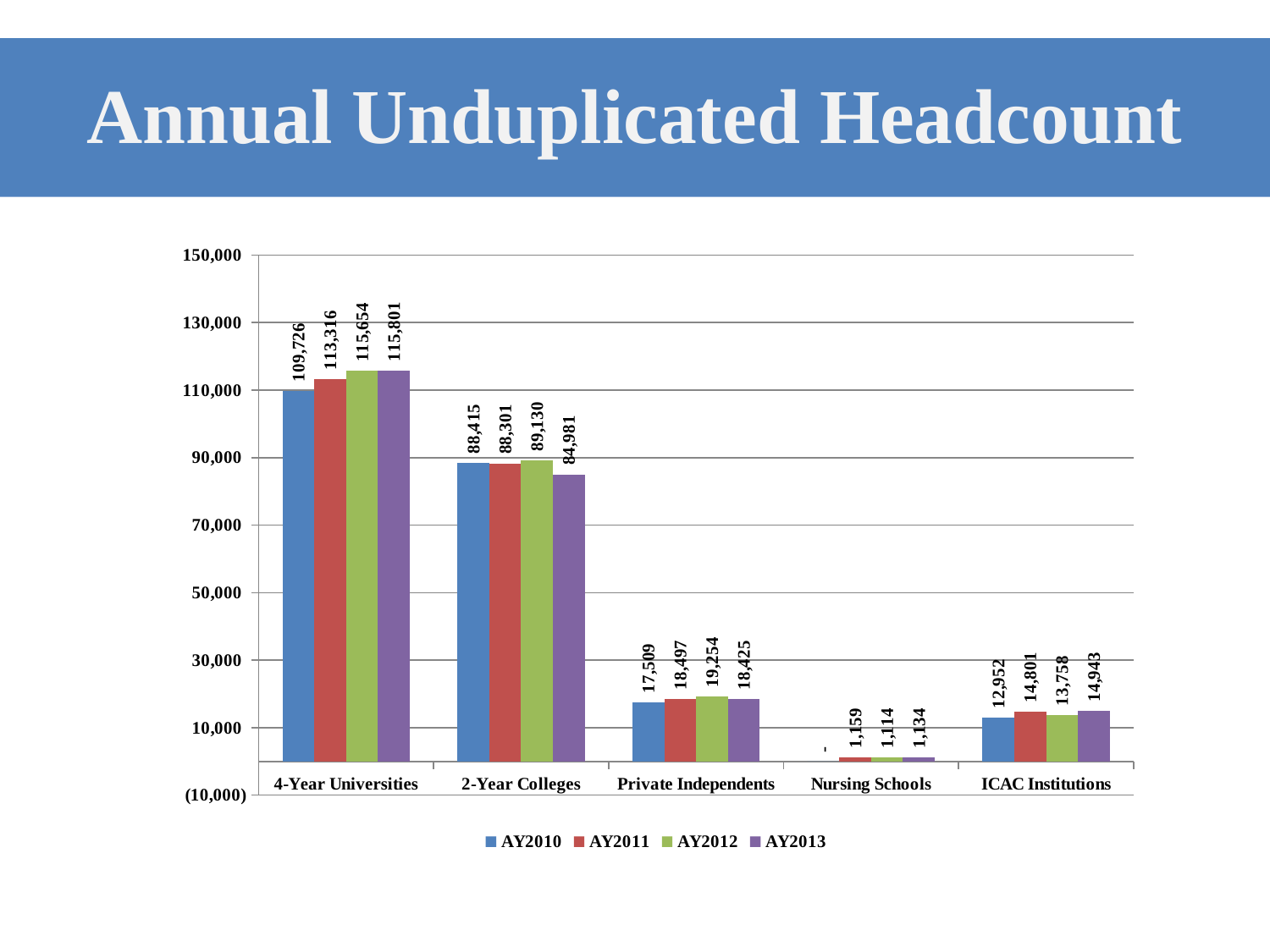
How many categories are shown on the x axis? 5 What is the AY2012 headcount for 4-Year Universities? 115,654 How many series does the legend list? 4 What is the AY2011 headcount for ICAC Institutions? 14,801 What is the AY2013 headcount for 2-Year Colleges? 84,981 Which is larger for ICAC Institutions: the AY2012 headcount or the AY2013 headcount? AY2013 What is the AY2010 headcount for Private Independents? 17,509 Is the AY2012 headcount for 2-Year Colleges greater or less than 90,000? less Which category has the lowest headcount in AY2011? Nursing Schools What type of chart is shown on the slide? bar chart What is the difference between the AY2013 and AY2010 headcounts for 4-Year Universities? 6,075 Which category has the highest headcount in AY2013? 4-Year Universities